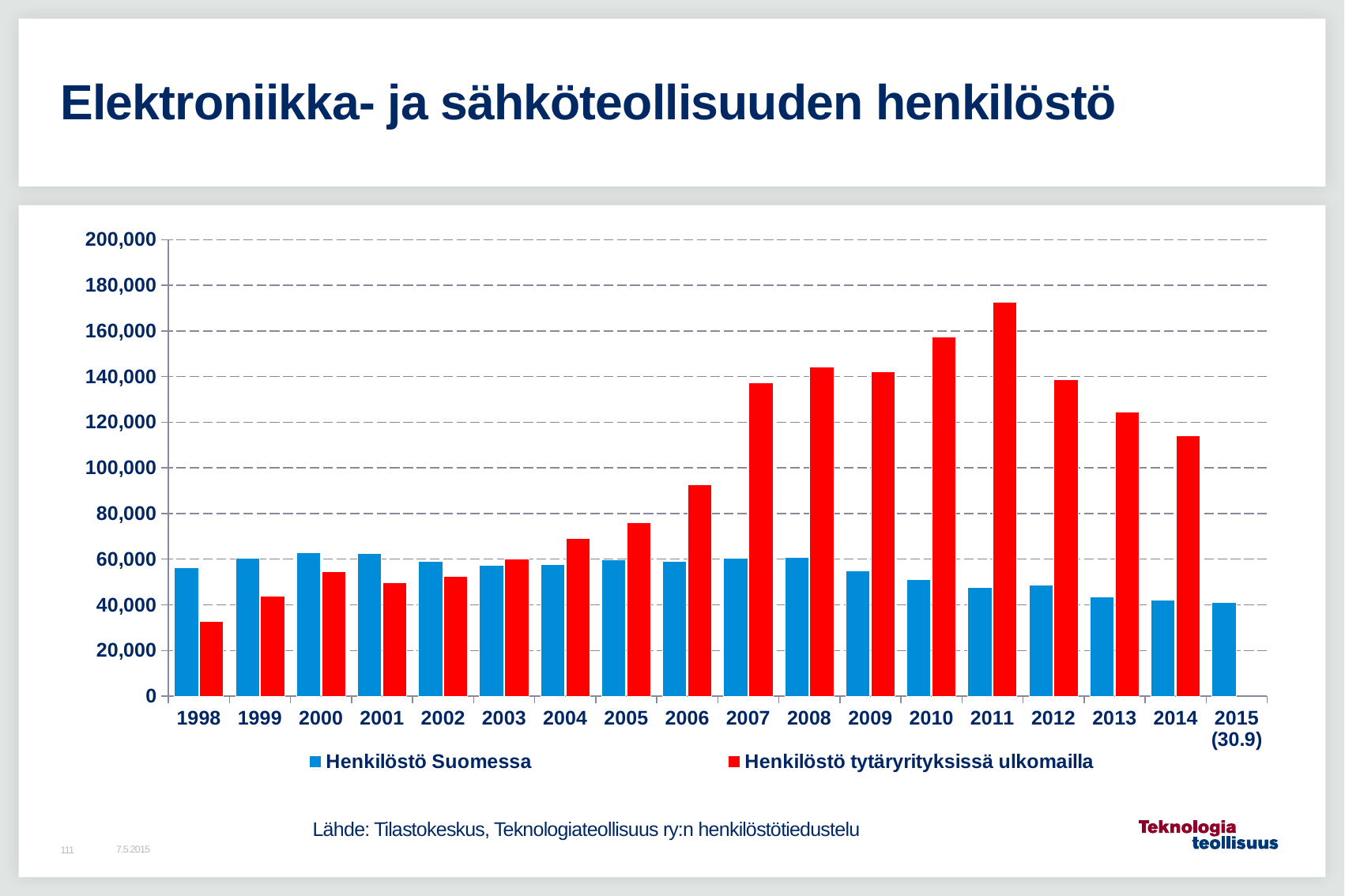
In which year is the value for Henkilöstö tytäryrityksissä ulkomailla highest? 2011 How many series does the legend list? 2 Is the value for Henkilöstö Suomessa in 1998 greater or less than 60,000? less Is the value for Henkilöstö tytäryrityksissä ulkomailla in 1998 greater or less than 40,000? less Does the value for Henkilöstö tytäryrityksissä ulkomailla rise or fall from 2011 to 2014? fall Is the value for Henkilöstö tytäryrityksissä ulkomailla in 2007 greater or less than 120,000? greater In 2010, which series has the larger value: Henkilöstö Suomessa or Henkilöstö tytäryrityksissä ulkomailla? Henkilöstö tytäryrityksissä ulkomailla In which year is the value for Henkilöstö tytäryrityksissä ulkomailla lowest? 1998 In 1998, which series has the larger value: Henkilöstö Suomessa or Henkilöstö tytäryrityksissä ulkomailla? Henkilöstö Suomessa How many years (categories) are shown on the x axis? 18 What kind of chart is shown on the slide? bar chart